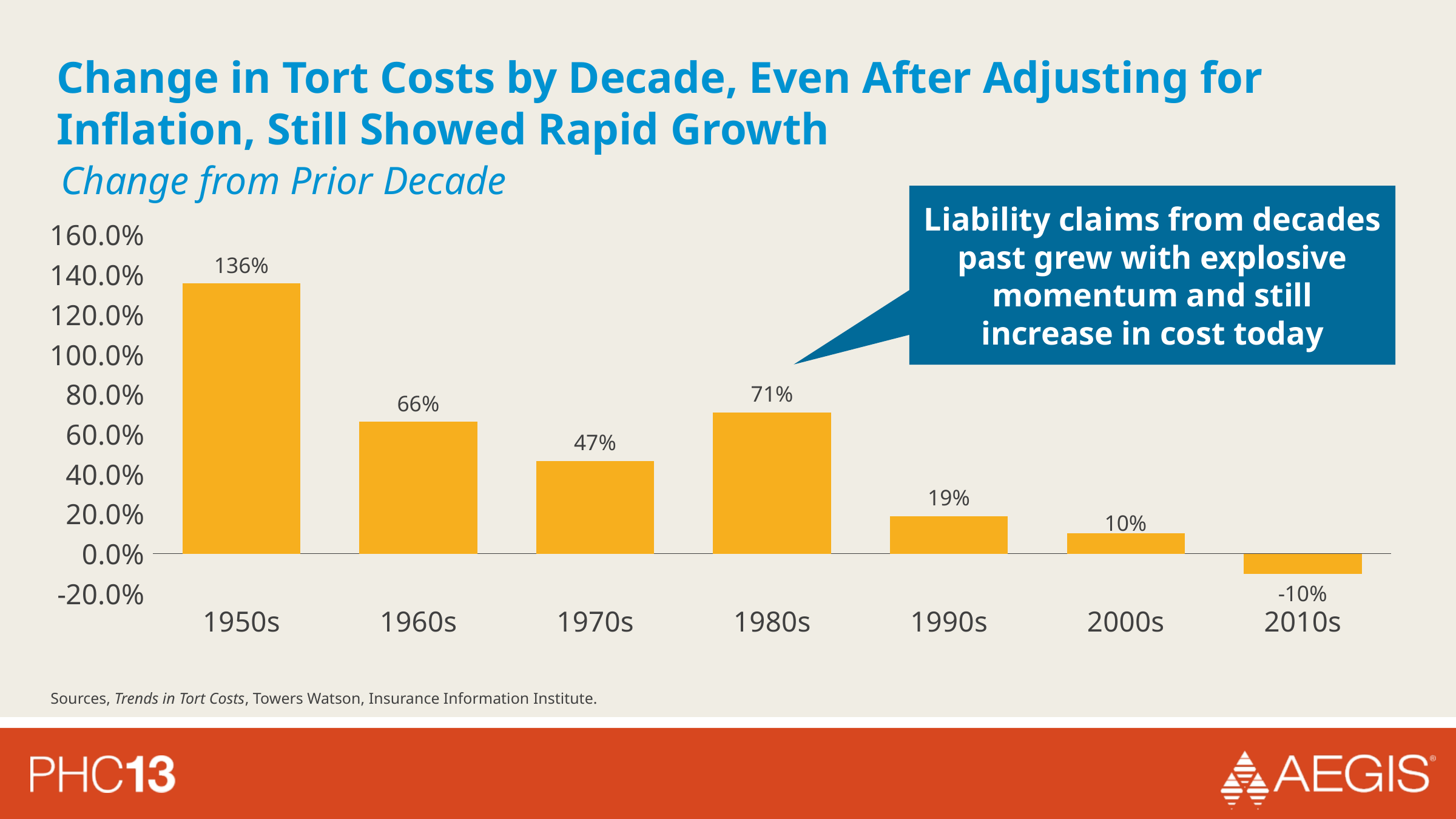
What is the change from prior decade shown for the 1980s? 71% What is the subtitle shown above the chart? Change from Prior Decade Is the value for the 1990s greater or less than 40.0%? less What is the difference between the 1960s value and the 1970s value? 19% What is the change from prior decade shown for the 2010s? -10% What is the change from prior decade shown for the 1950s? 136% Which decade has the highest change from prior decade? 1950s Which is larger, the value for the 1980s or the value for the 1960s? 1980s Do the values generally rise or fall from the 1980s to the 2010s? Fall How many decades are plotted on the chart? 7 What kind of chart is shown on the slide? Bar chart Which decade has the lowest change from prior decade? 2010s